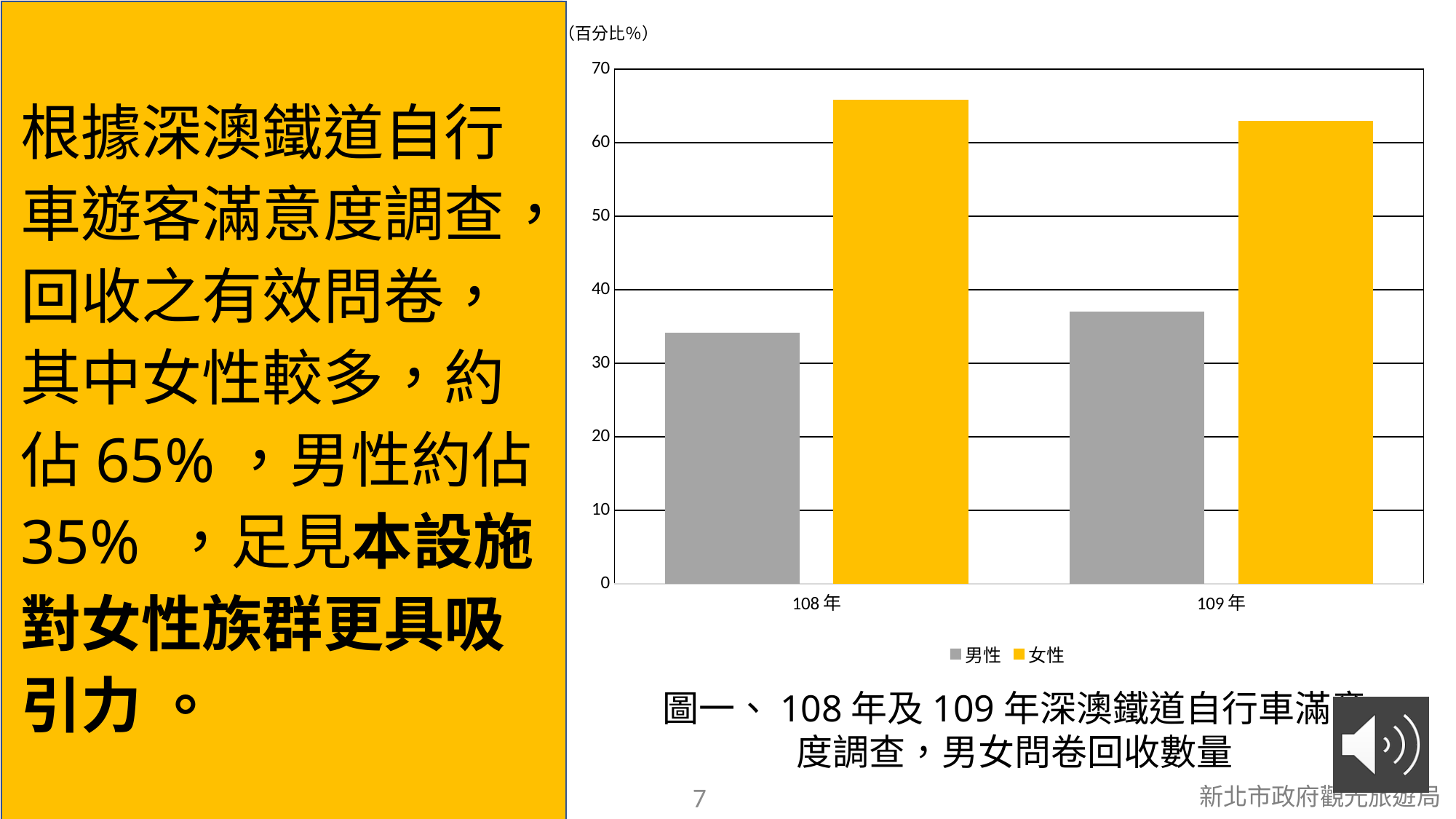
Is the value for 男性 in 109 年 greater or less than 40? less In 108 年, which is larger, the value for 男性 or the value for 女性? 女性 Is the value for 女性 in 108 年 greater or less than 60? greater Which series is represented by the yellow bars in the chart? 女性 Does the value for 男性 rise or fall from 108 年 to 109 年? rise What unit label is shown at the top of the chart's vertical axis? (百分比%) Which bar in the chart is the tallest? 女性 in 108 年 In 109 年, which is larger, the value for 男性 or the value for 女性? 女性 What kind of chart is shown on the slide? bar chart How many series does the chart legend list? 2 How many year categories are shown on the x axis of the chart? 2 Is the value for 男性 in 108 年 greater or less than 40? less